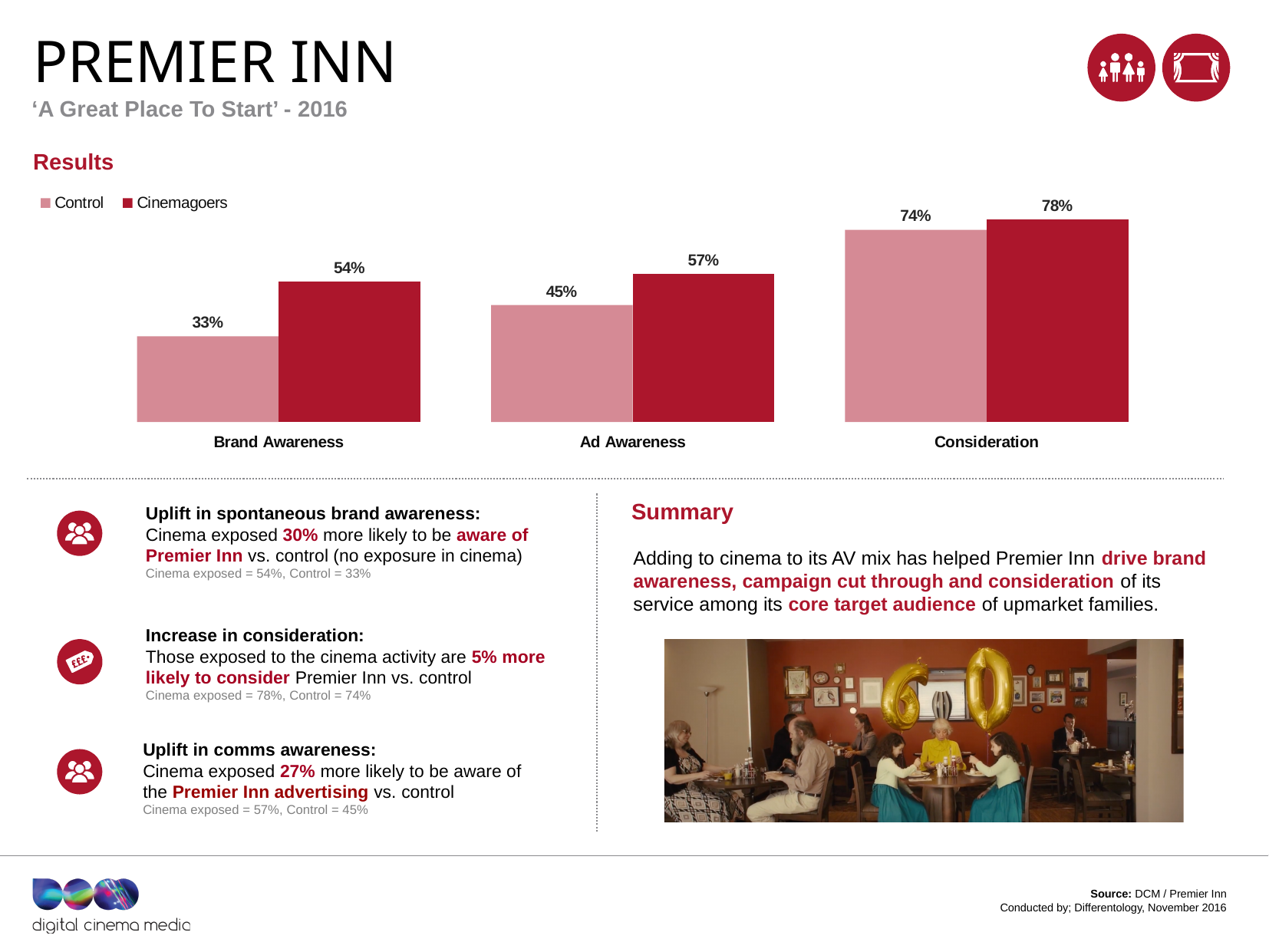
What is the Control value for Ad Awareness? 45% What is the difference between the Cinemagoers and Control values for Brand Awareness? 21% How many categories are shown on the x axis of the chart? 3 Which category has the highest Cinemagoers value? Consideration Which is larger for Consideration, the Control value or the Cinemagoers value? Cinemagoers What is the difference between the Cinemagoers and Control values for Ad Awareness? 12% Which series is shown in the darker red colour in the chart? Cinemagoers What is the Cinemagoers value for Brand Awareness? 54% What is the Control value for Consideration? 74% Which category has the lowest Control value? Brand Awareness What kind of chart is shown on the slide? Bar chart How many series does the chart legend list? 2